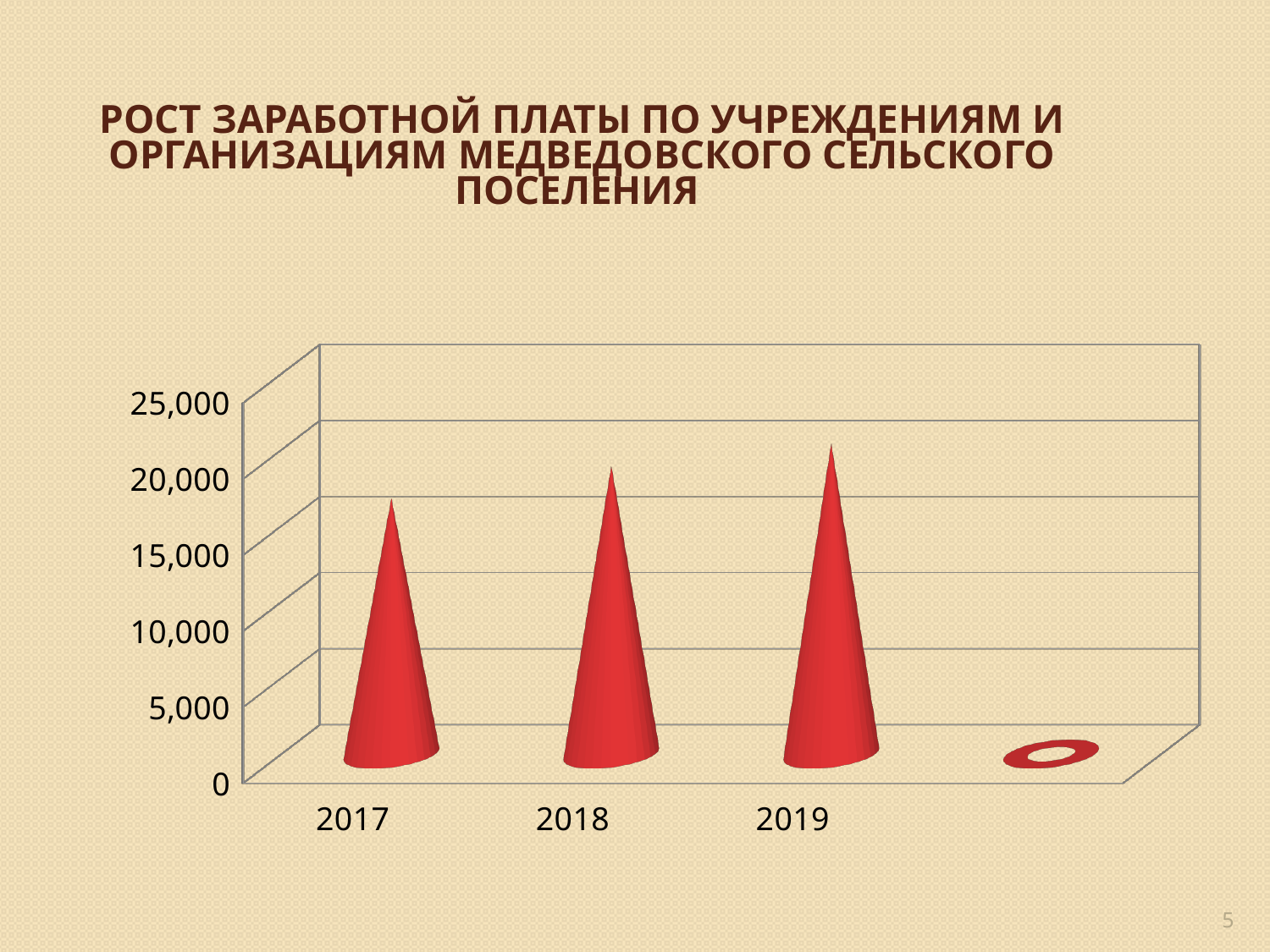
Is the value for 2018 greater or less than 15,000? greater Which is larger, the value for 2019 or the value for 2017? 2019 Is the value for 2019 greater or less than 25,000? less Which year has the highest value on the chart? 2019 Do the values rise or fall from 2017 to 2019? rise What is the highest value shown on the vertical axis? 25,000 Which year has the lowest value among the labeled years? 2017 How many years are labeled on the x axis? 3 Is the value for 2017 greater or less than 15,000? greater What kind of chart is shown on the slide? bar chart